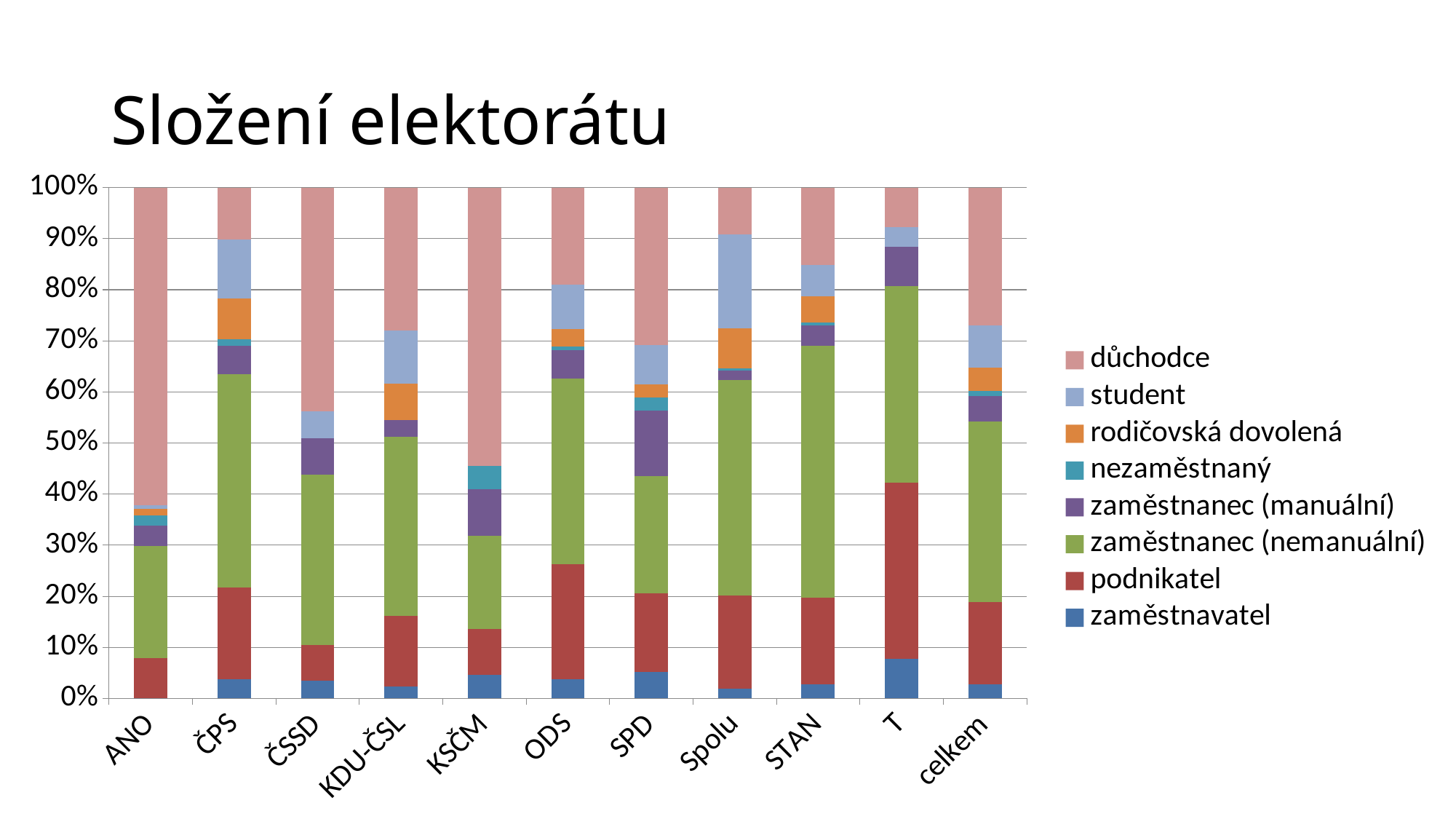
Is the důchodce share larger for ANO or for T? ANO Which category has the largest podnikatel share? T Is the zaměstnavatel share for T greater or less than 5%? greater Which category has the largest student share? Spolu Which legend entry is shown in green? zaměstnanec (nemanuální) Is the podnikatel share larger for T or for ANO? T What kind of chart is shown on the slide? stacked bar chart Which category has the largest důchodce share? ANO What is the title of the chart? Složení elektorátu What is the total of the stacked bar for celkem? 100% How many series does the legend list? 8 How many categories are shown along the x axis? 11